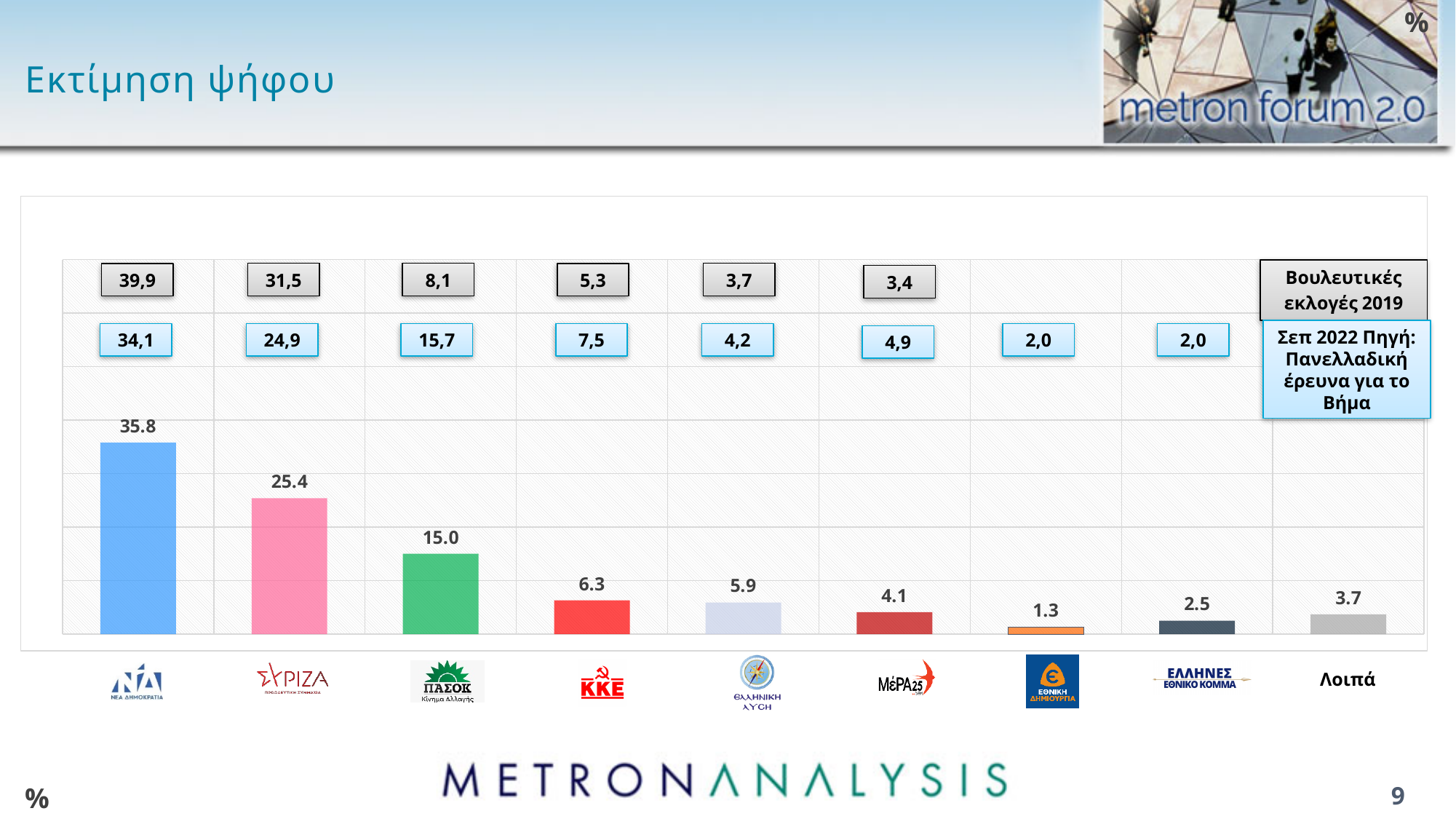
What is the difference between the bar values for ΝΕΑ ΔΗΜΟΚΡΑΤΙΑ and ΣΥΡΙΖΑ? 10.4 What is the plotted value of the bar for ΠΑΣΟΚ? 15.0 Which category has the lowest bar in the chart? ΕΘΝΙΚΗ ΔΗΜΙΟΥΡΓΙΑ What is the plotted value of the bar for ΝΕΑ ΔΗΜΟΚΡΑΤΙΑ (ΝΔ)? 35.8 What is the plotted value of the bar for ΚΚΕ? 6.3 Which party has the highest bar in the chart? ΝΕΑ ΔΗΜΟΚΡΑΤΙΑ What value is shown for ΠΑΣΟΚ in the 'Σεπ 2022' row? 15,7 What is the title of the chart on the slide? Εκτίμηση ψήφου Which bar is larger: ΚΚΕ or ΕΛΛΗΝΙΚΗ ΛΥΣΗ? ΚΚΕ How many categories (bars) are shown in the chart? 9 What value is shown for ΣΥΡΙΖΑ in the 'Βουλευτικές εκλογές 2019' row? 31,5 What kind of chart is shown on the slide? Bar chart